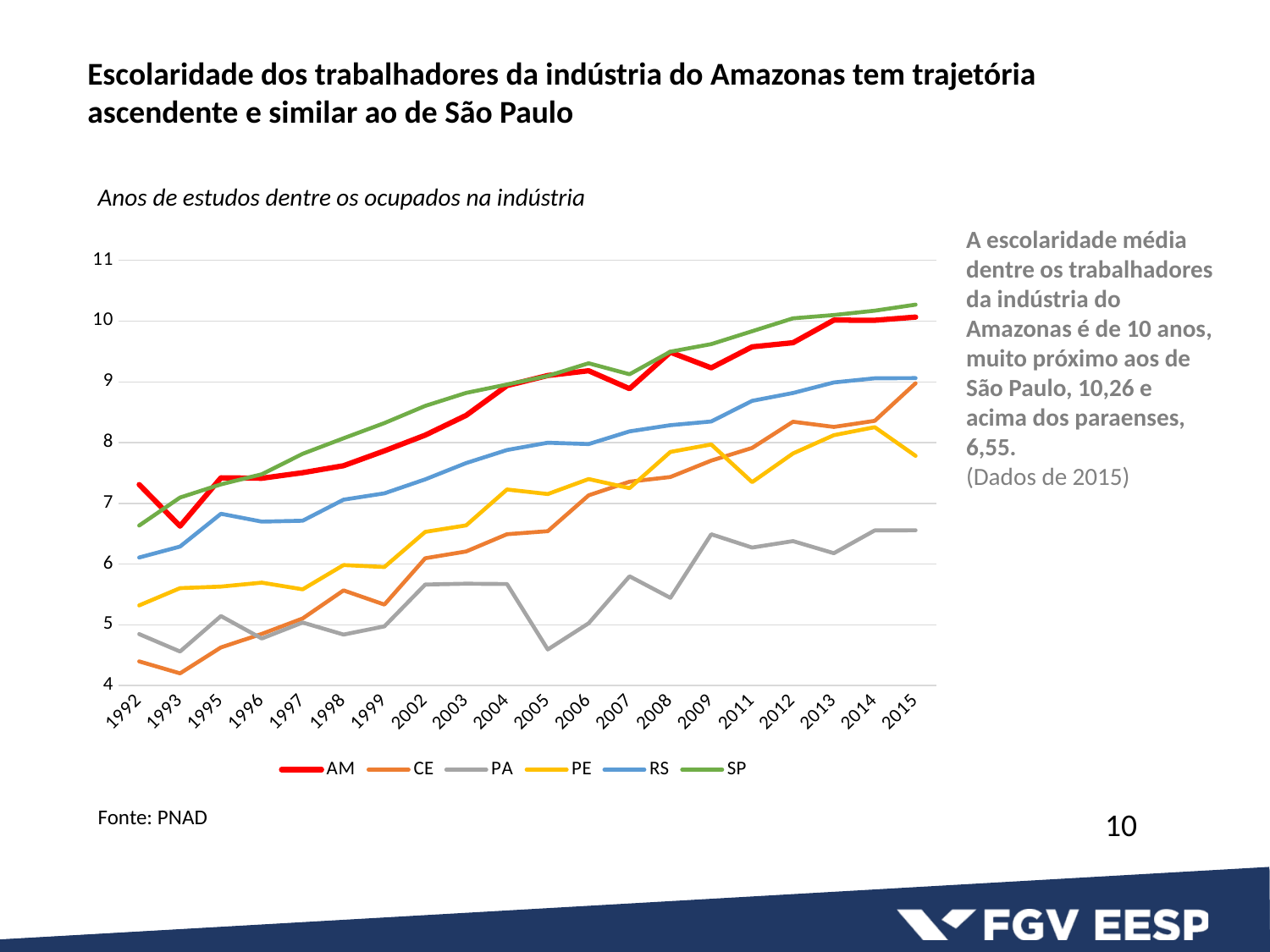
Which is larger in 2015, the value for AM or the value for PA? AM Is the value for PA in 2015 greater or less than 7? less Which series has the highest value in 2015? SP Does the SP series rise or fall from 1992 to 2015? rise Which series has the lowest value in 2015? PA What colour is the AM line in the chart? red How many series does the legend list? 6 What kind of chart is shown on the slide? line chart Is the value for CE in 1993 greater or less than 5? less How many years are shown on the x axis? 20 Is the value for SP in 2015 greater or less than 10? greater